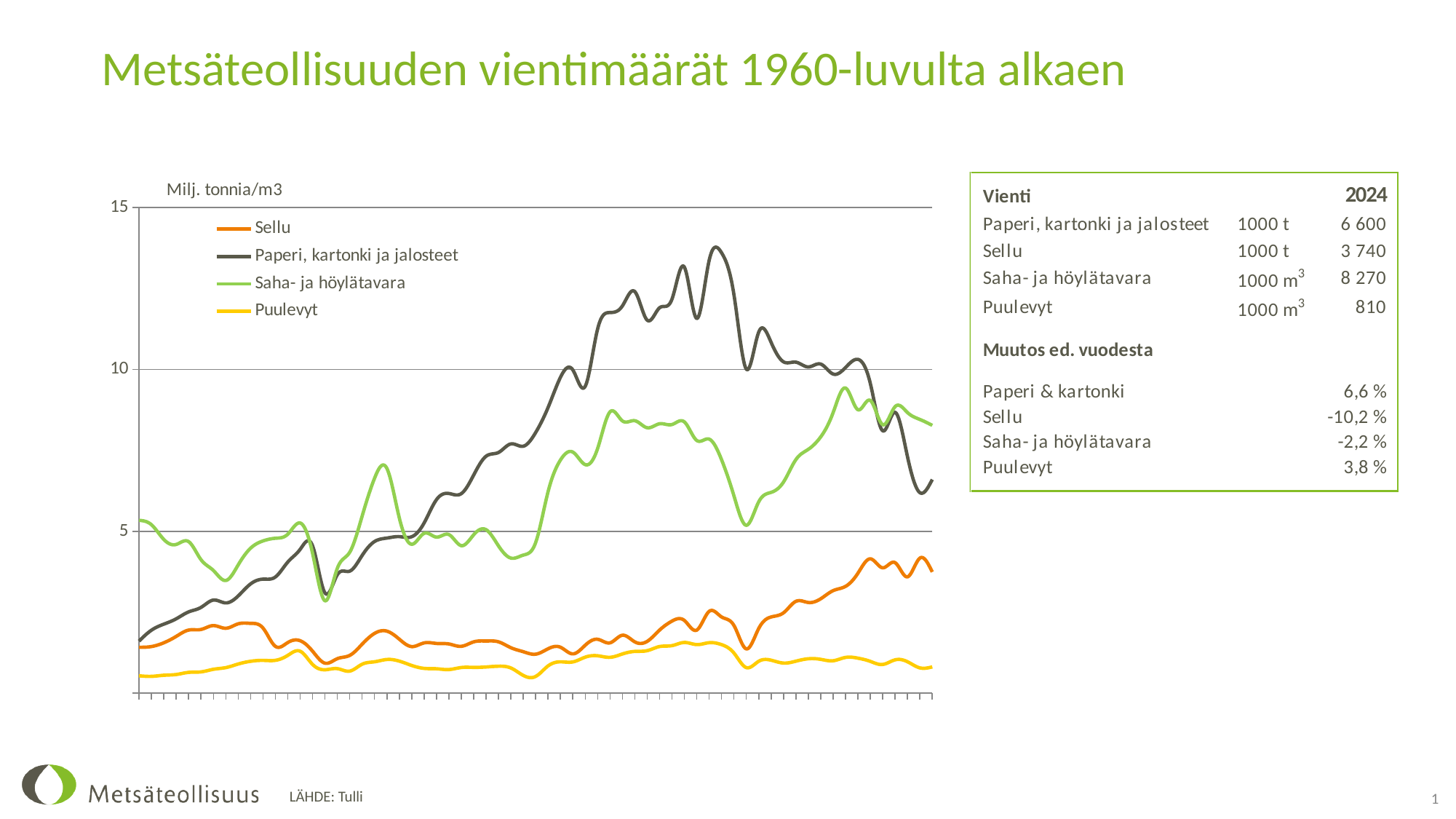
Is the peak value of Paperi, kartonki ja jalosteet greater or less than 10? greater How many series does the chart legend list? 4 At the right end of the chart, which is higher: Saha- ja höylätavara or Paperi, kartonki ja jalosteet? Saha- ja höylätavara What unit label is shown above the y axis of the chart? Milj. tonnia/m3 Does the Sellu series overall rise or fall from the left of the chart to the right? rise At the right end of the chart, is the value for Sellu greater or less than 5? less At the right end of the chart, is the value for Saha- ja höylätavara greater or less than 5? greater What kind of chart is shown on the slide? line chart At the right end of the chart, which is higher: Sellu or Puulevyt? Sellu Which series stays lowest across the whole chart? Puulevyt Which series reaches the highest value anywhere on the chart? Paperi, kartonki ja jalosteet